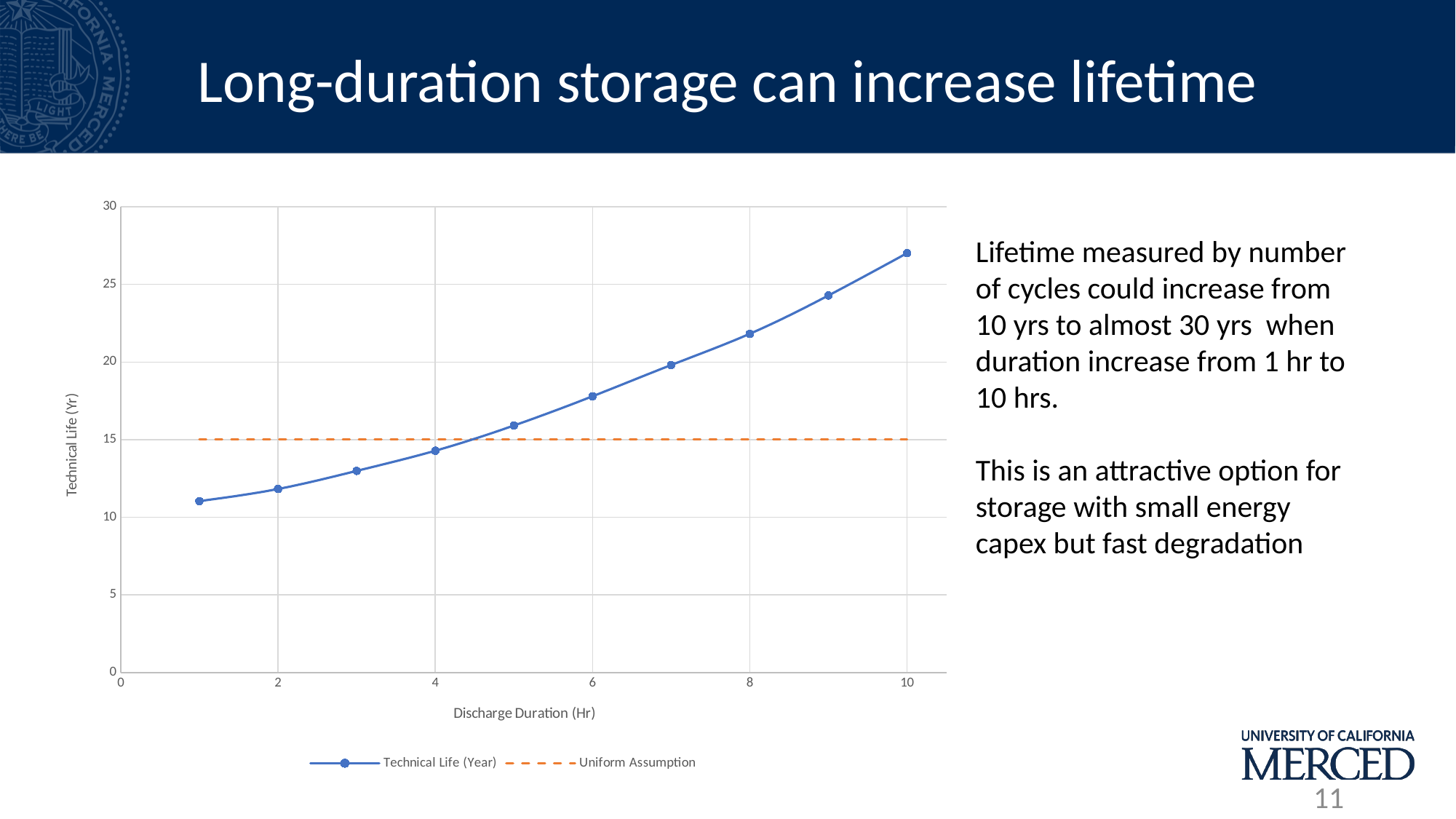
Which is larger at a discharge duration of 8 hours: the Technical Life (Year) value or the Uniform Assumption value? Technical Life (Year) Is the Technical Life (Year) value at a discharge duration of 10 hours greater or less than 25? greater How many series does the legend list? 2 What is the title of the x axis? Discharge Duration (Hr) What value does the Uniform Assumption line sit at on the Technical Life axis? 15 What kind of chart is shown on the slide? line chart How many data points are plotted on the Technical Life (Year) line? 10 What is the title of the y axis? Technical Life (Yr) At which discharge duration is the Technical Life (Year) value lowest? 1 Does the Technical Life (Year) line rise or fall as discharge duration increases? rises Is the Technical Life (Year) value at a discharge duration of 2 hours greater or less than 15? less At which discharge duration is the Technical Life (Year) value highest? 10